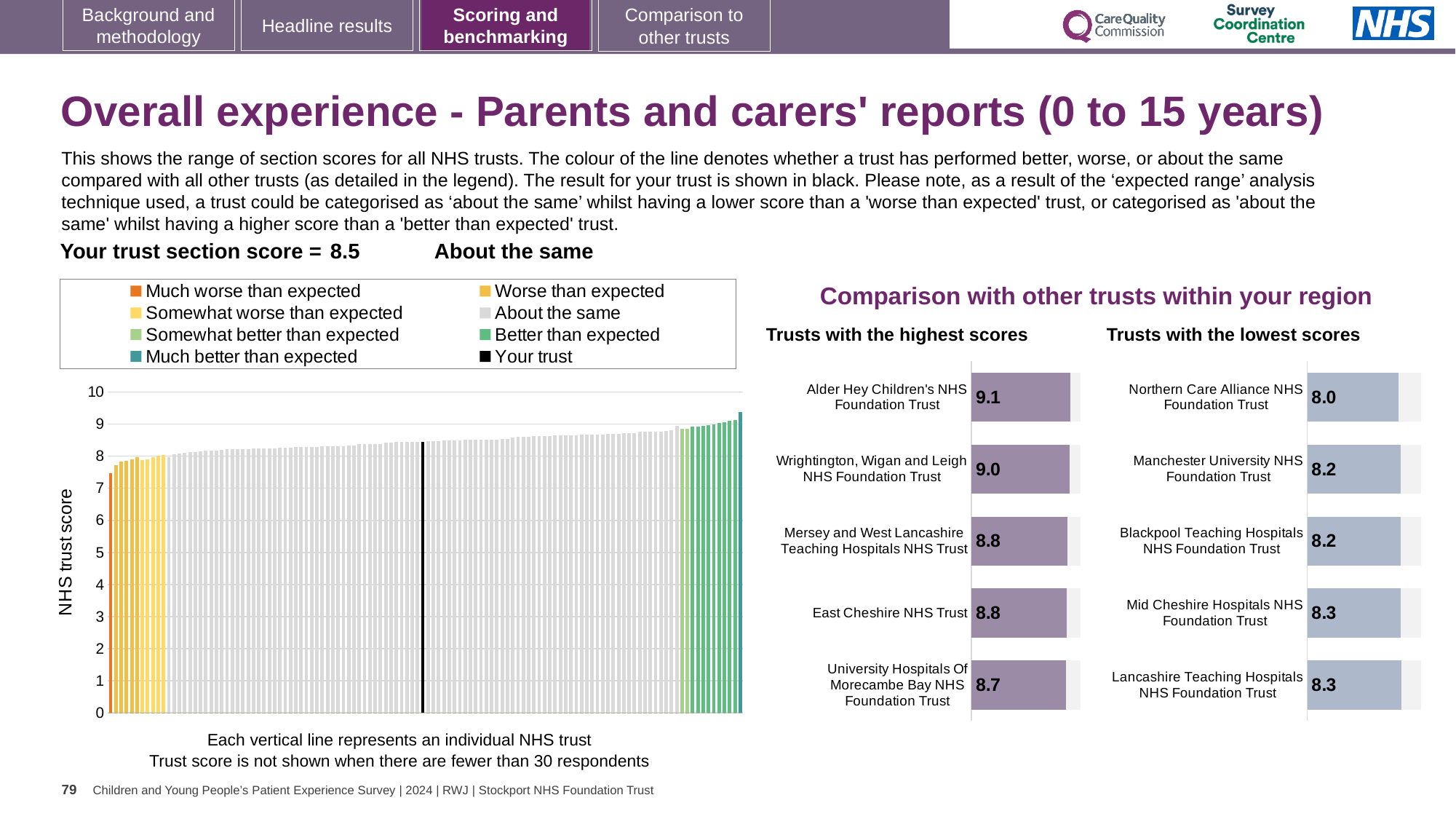
Which has the higher score: Wrightington, Wigan and Leigh NHS Foundation Trust in the highest scores chart, or Manchester University NHS Foundation Trust in the lowest scores chart? Wrightington, Wigan and Leigh NHS Foundation Trust In the large chart on the left showing all NHS trusts, is the value of the black bar (your trust) greater or less than 8? greater In the 'Trusts with the lowest scores' chart, what is the score for Mid Cheshire Hospitals NHS Foundation Trust? 8.3 In the 'Trusts with the highest scores' chart, what is the difference between the scores of Alder Hey Children's NHS Foundation Trust and University Hospitals Of Morecambe Bay NHS Foundation Trust? 0.4 In the 'Trusts with the lowest scores' chart, which trust has the lowest score? Northern Care Alliance NHS Foundation Trust In the 'Trusts with the highest scores' chart, what is the score for University Hospitals Of Morecambe Bay NHS Foundation Trust? 8.7 What is the y-axis label of the large chart on the left showing all NHS trusts? NHS trust score In the 'Trusts with the lowest scores' chart, what is the score for Northern Care Alliance NHS Foundation Trust? 8.0 In the large chart on the left showing all NHS trusts, is the value of the lowest (leftmost) bar greater or less than 8? less In the 'Trusts with the highest scores' chart, which trust has the highest score? Alder Hey Children's NHS Foundation Trust How many trusts are shown in the 'Trusts with the lowest scores' chart? 5 In the 'Trusts with the highest scores' chart, what is the score for Alder Hey Children's NHS Foundation Trust? 9.1